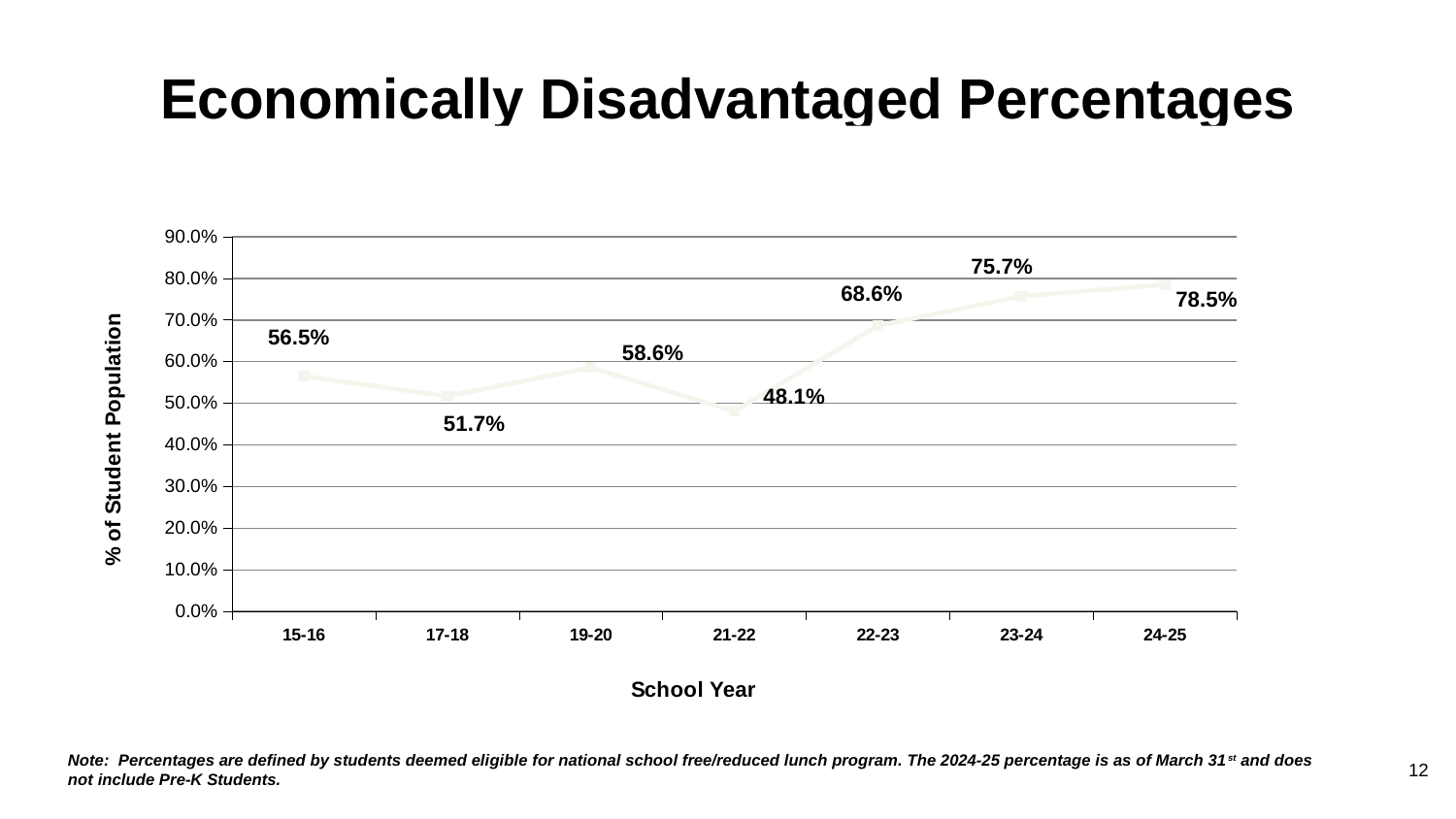
What is the label of the y axis? % of Student Population Which school year has a higher percentage, 19-20 or 17-18? 19-20 What is the economically disadvantaged percentage for school year 15-16? 56.5% Do the values rise or fall from school year 21-22 to 24-25? rise How many school years are plotted on the chart? 7 Is the value for school year 22-23 greater or less than 60.0%? greater Which school year has the lowest economically disadvantaged percentage? 21-22 Which school year has the highest economically disadvantaged percentage? 24-25 What is the economically disadvantaged percentage for school year 21-22? 48.1% What kind of chart is shown on the slide? line chart What is the difference in percentage points between school years 24-25 and 21-22? 30.4 What is the economically disadvantaged percentage for school year 24-25? 78.5%